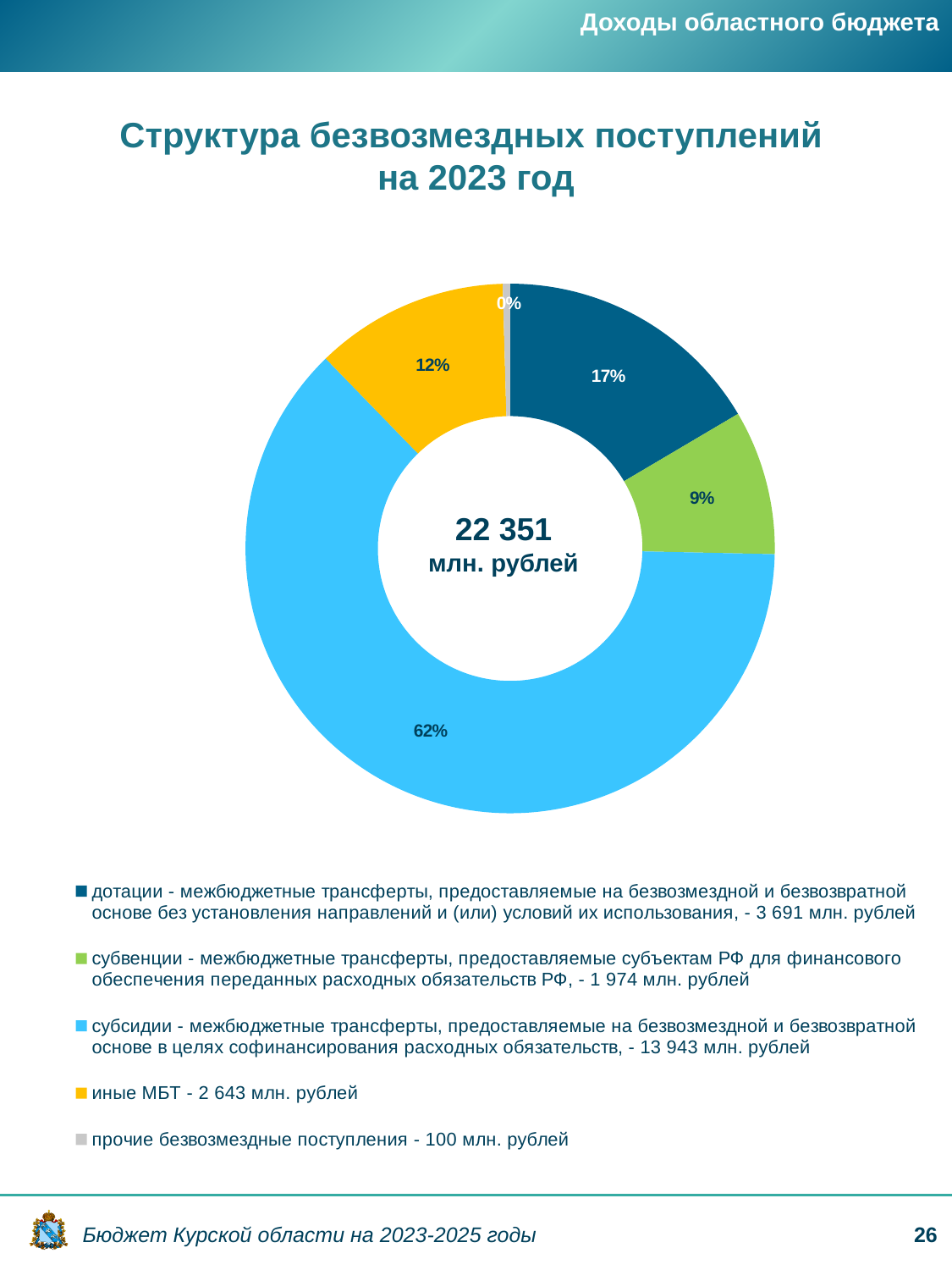
Какую долю составляют субвенции? 9% Какая категория имеет наименьшую долю в структуре безвозмездных поступлений? прочие безвозмездные поступления Что больше: доля дотаций или доля иных МБТ? доля дотаций Сколько категорий показано на диаграмме? 5 Какова общая сумма безвозмездных поступлений, указанная в центре диаграммы? 22 351 млн. рублей На сколько процентных пунктов доля субсидий больше доли дотаций? 45 Какую долю безвозмездных поступлений составляют дотации? 17% Какую долю составляют иные МБТ? 12% Какой тип диаграммы показан на слайде? кольцевая (круговая) диаграмма Какая категория имеет наибольшую долю в структуре безвозмездных поступлений? субсидии Какой объём субсидий в млн. рублей указан в легенде? 13 943 млн. рублей